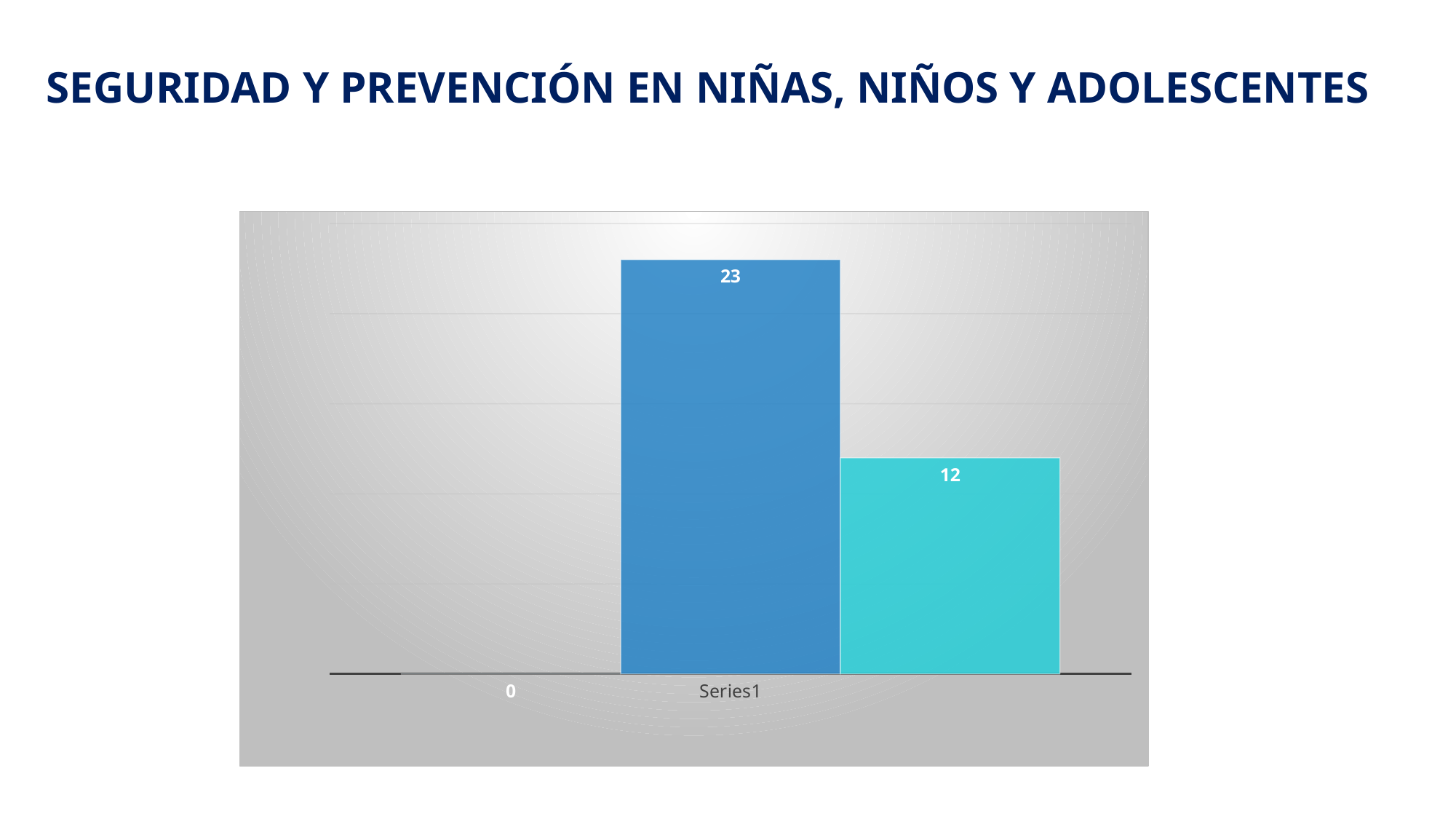
What is the title of the slide containing the chart? SEGURIDAD Y PREVENCIÓN EN NIÑAS, NIÑOS Y ADOLESCENTES Which bar has the highest value, the dark blue bar or the light cyan bar? dark blue bar What type of chart is shown on the slide? bar chart What is the value of the leftmost data label, to the left of the dark blue bar? 0 What value is printed on the dark blue bar? 23 What is the lowest value labelled on the chart? 0 Is the value of the dark blue bar larger or smaller than the value of the light cyan bar? larger How many data labels are printed on the chart? 3 What value is printed on the light cyan bar? 12 What is the difference between the dark blue bar's value and the light cyan bar's value? 11 What category label appears on the x axis of the chart? Series1 What is the total of the three labelled values on the chart? 35